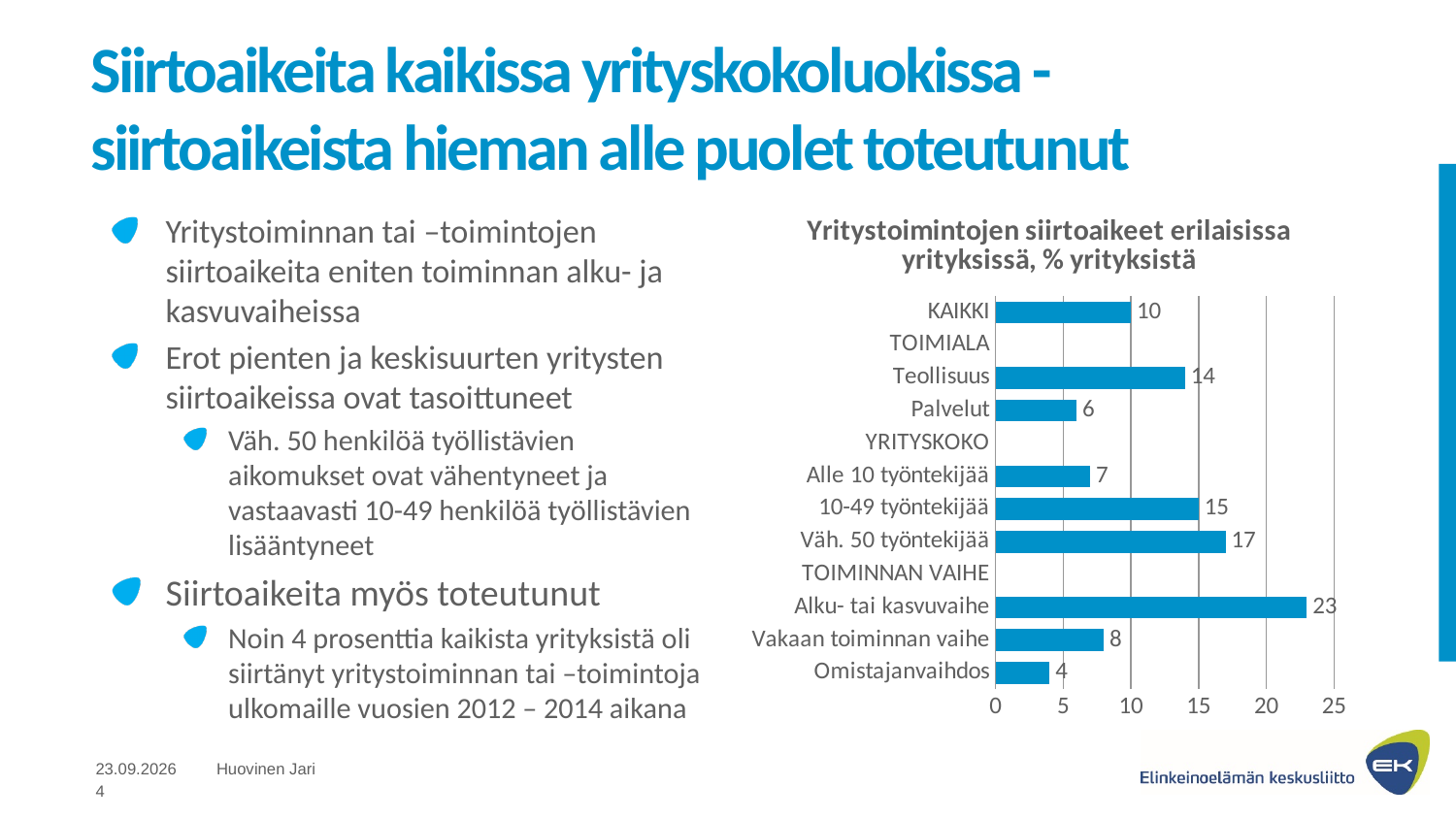
Which category has the lowest value? Omistajanvaihdos Is the value for Vakaan toiminnan vaihe greater or less than 10? less What kind of chart is shown on the slide? bar chart Which category has the highest value? Alku- tai kasvuvaihe What is the value for Alku- tai kasvuvaihe? 23 What is the title of the chart? Yritystoimintojen siirtoaikeet erilaisissa yrityksissä, % yrityksistä What is the value for KAIKKI? 10 What is the value for Teollisuus? 14 What is the value for Väh. 50 työntekijää? 17 Which is larger, the value for 10-49 työntekijää or the value for Alle 10 työntekijää? 10-49 työntekijää What is the difference between the values for Teollisuus and Palvelut? 8 How many bars with data labels are plotted in the chart? 9